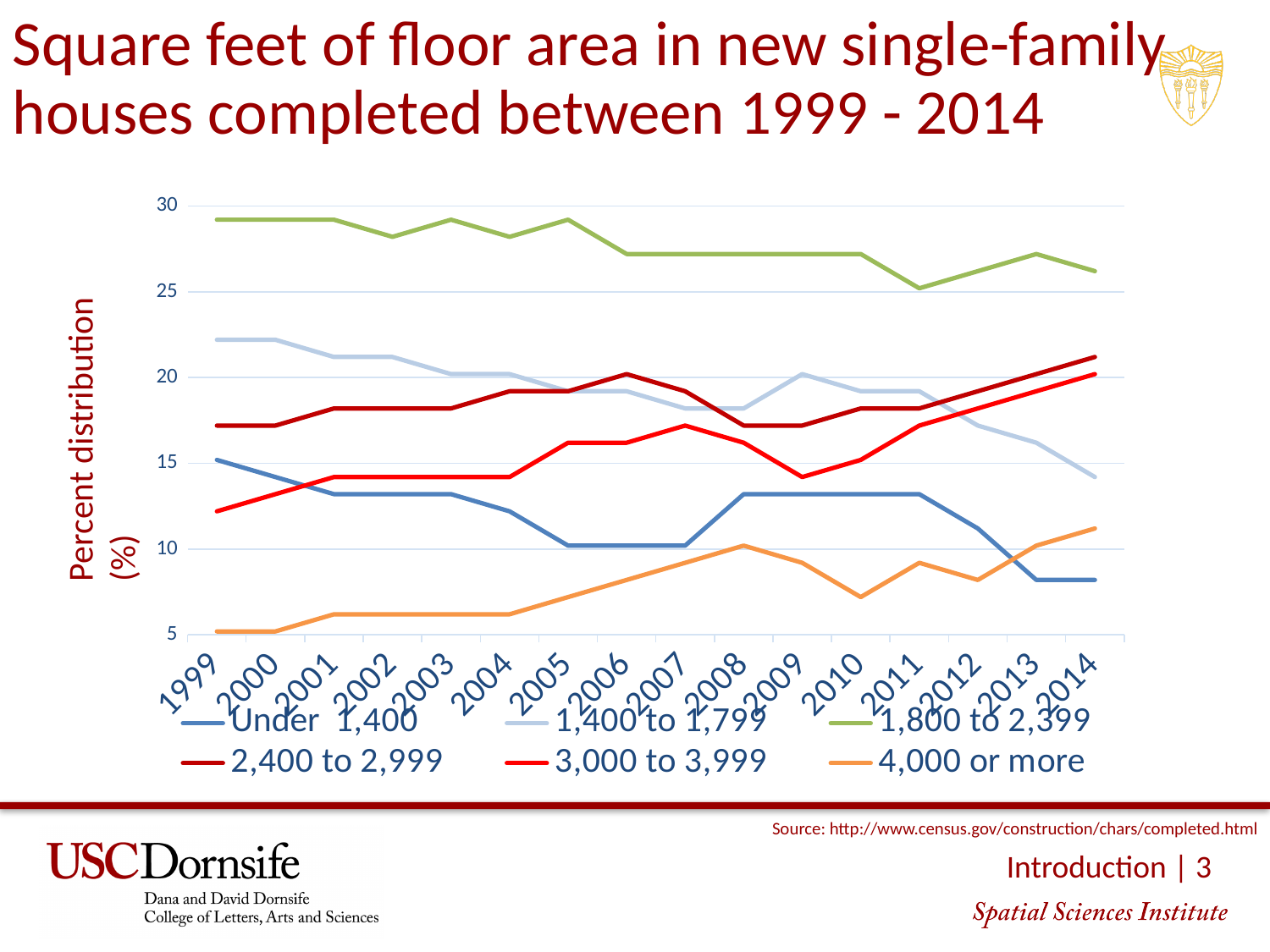
In 2014, which is larger: '2,400 to 2,999' or '1,400 to 1,799'? 2,400 to 2,999 Which series has the lowest value in 1999? 4,000 or more Is the value for '4,000 or more' in 2014 greater or less than 10? greater Which series has the highest values across the whole period? 1,800 to 2,399 How many series does the legend list? 6 What kind of chart is shown on the slide? line chart How many years are plotted along the x axis? 16 Is the value for 'Under 1,400' in 2014 greater or less than 10? less Does the '1,400 to 1,799' series generally rise or fall from 1999 to 2014? fall Which series has the lowest value in 2014? Under 1,400 Does the '4,000 or more' series generally rise or fall from 1999 to 2014? rise Is the value for '1,800 to 2,399' in 1999 greater or less than 25? greater